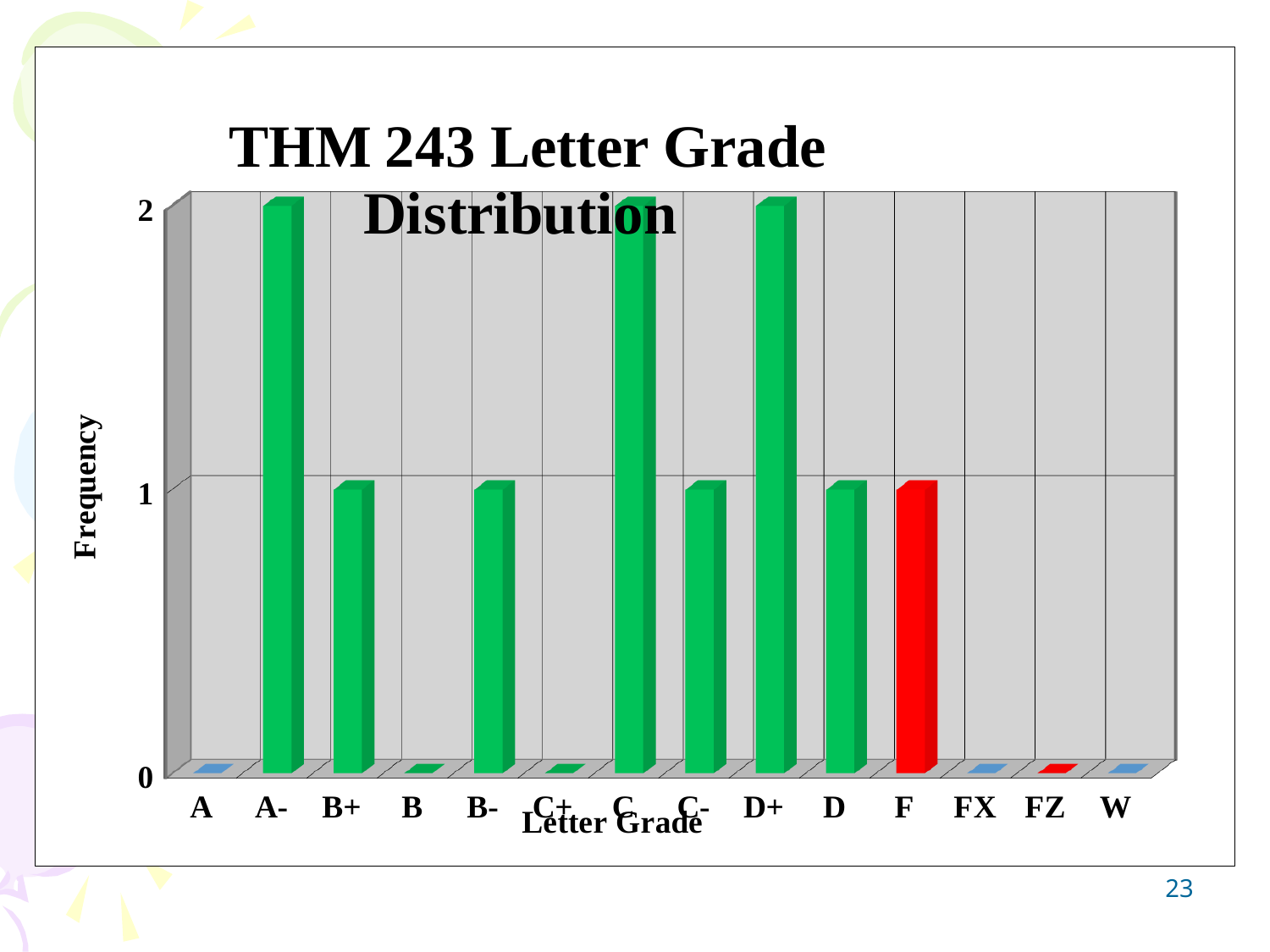
How many letter grade categories are shown on the x axis? 14 What is the frequency for the A- grade? 2 What is the difference between the frequency for A- and the frequency for B-? 1 What is the title of the chart? THM 243 Letter Grade Distribution What is the frequency for the F grade? 1 What is the frequency for the D+ grade? 2 What is the frequency for the B+ grade? 1 What is the frequency for the W grade? 0 What is the label of the y axis? Frequency Which is larger, the frequency for D or the frequency for FX? D Which is larger, the frequency for C or the frequency for C-? C What type of chart is shown on the slide? bar chart